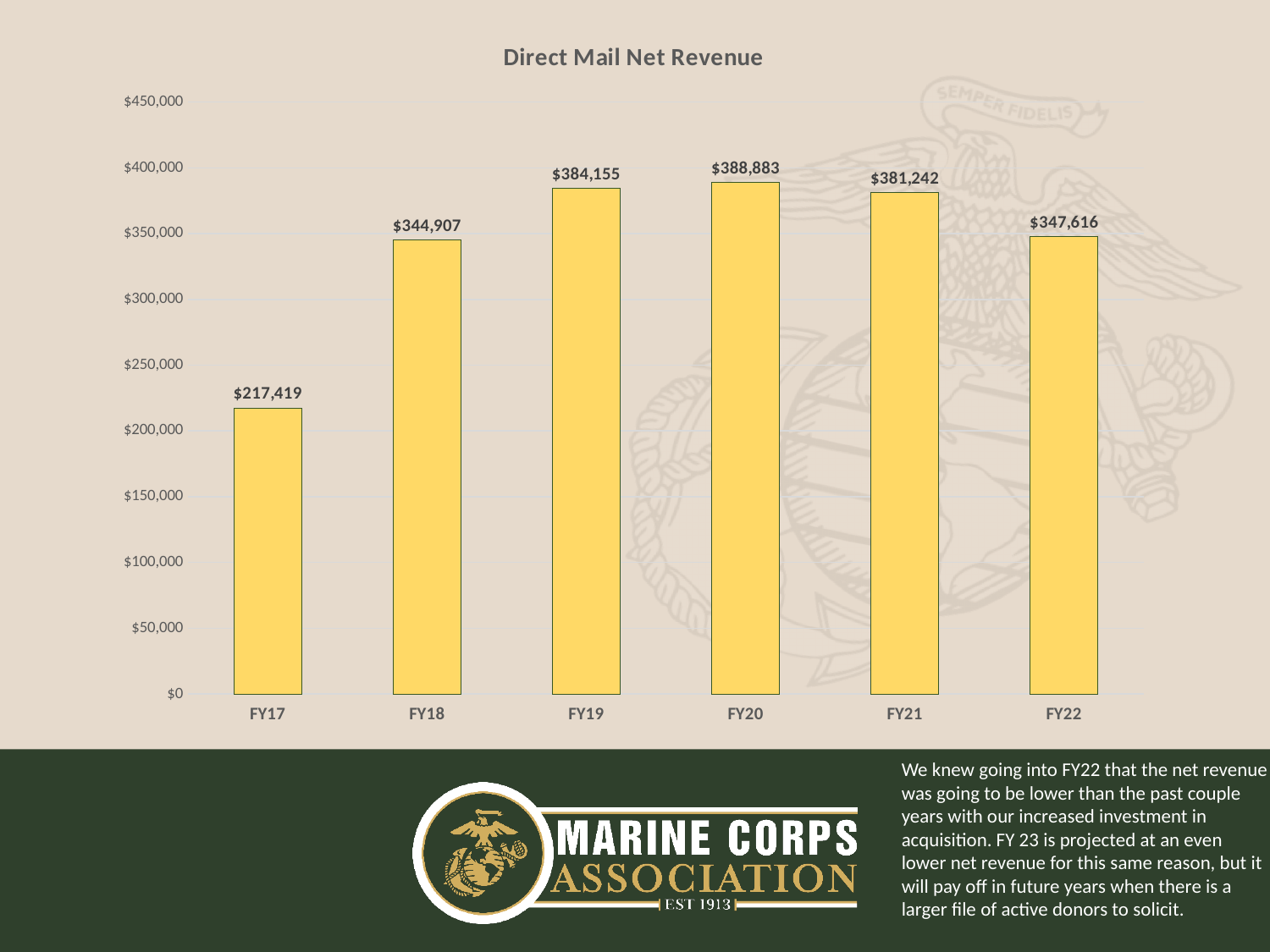
What is the difference in Direct Mail Net Revenue between FY21 and FY22? $33,626 What is the Direct Mail Net Revenue for FY17? $217,419 What is the title of the chart on the slide? Direct Mail Net Revenue What is the Direct Mail Net Revenue for FY22? $347,616 Which fiscal year has the highest Direct Mail Net Revenue? FY20 Is the Direct Mail Net Revenue for FY21 greater or less than $350,000? greater What is the difference in Direct Mail Net Revenue between FY18 and FY17? $127,488 What kind of chart is used to show Direct Mail Net Revenue? Bar chart What is the Direct Mail Net Revenue for FY20? $388,883 Which has a higher Direct Mail Net Revenue, FY19 or FY22? FY19 How many fiscal years are shown in the Direct Mail Net Revenue chart? 6 Which fiscal year has the lowest Direct Mail Net Revenue? FY17